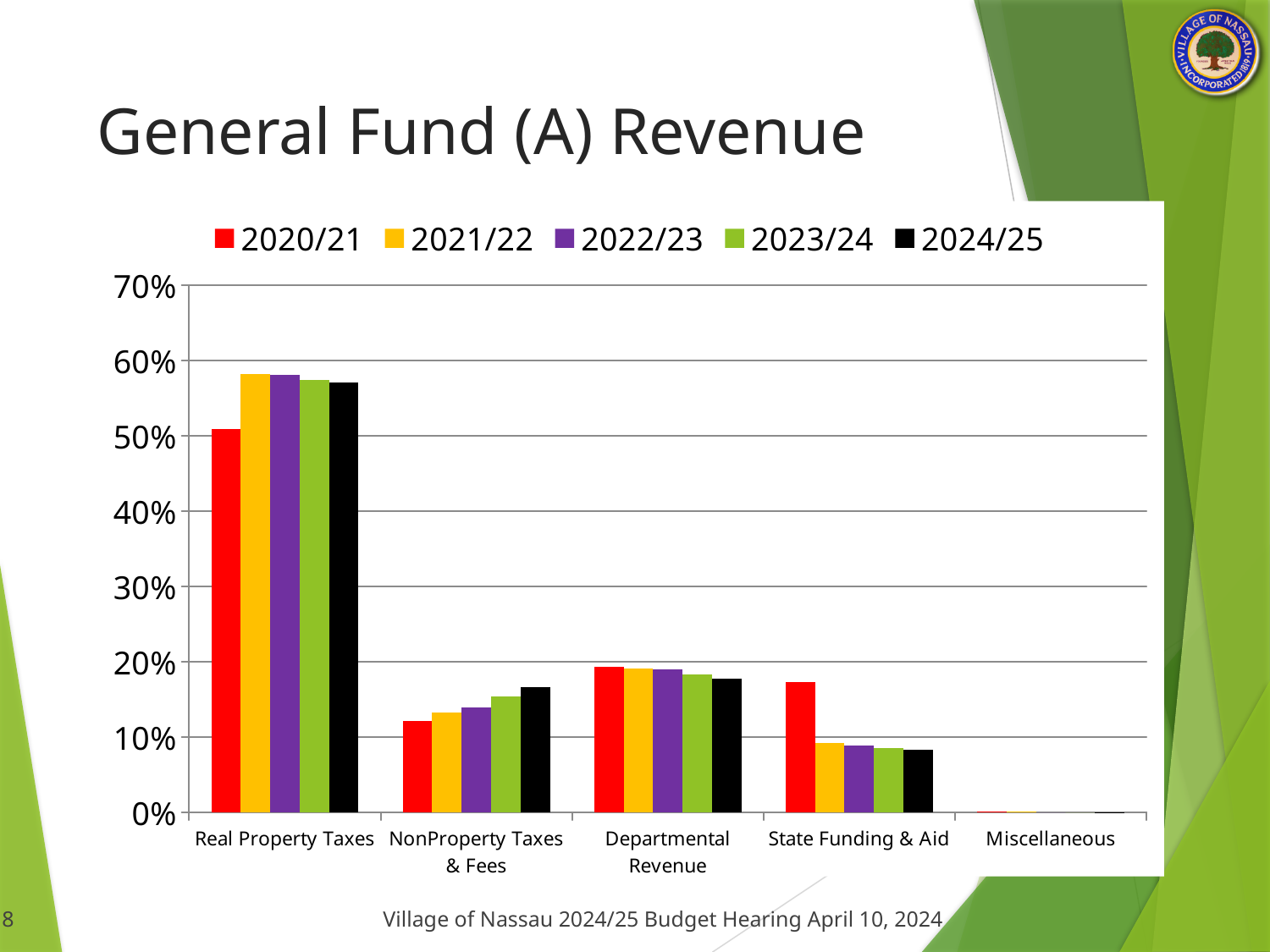
What kind of chart is shown on the slide? Bar chart Do the values for NonProperty Taxes & Fees rise or fall from 2020/21 to 2024/25? rise Is the value for State Funding & Aid in 2024/25 greater or less than 10%? less Is the value for State Funding & Aid in 2020/21 greater or less than 10%? greater Do the values for Departmental Revenue rise or fall from 2020/21 to 2024/25? fall How many revenue categories are shown on the x axis? 5 What colour represents the 2024/25 series in the legend? Black Which revenue category has the lowest share across all years? Miscellaneous Is the value for Real Property Taxes in 2021/22 greater or less than 60%? less How many series does the legend list? 5 For State Funding & Aid, which is larger: the 2020/21 value or the 2021/22 value? 2020/21 Which revenue category has the highest share in 2024/25? Real Property Taxes